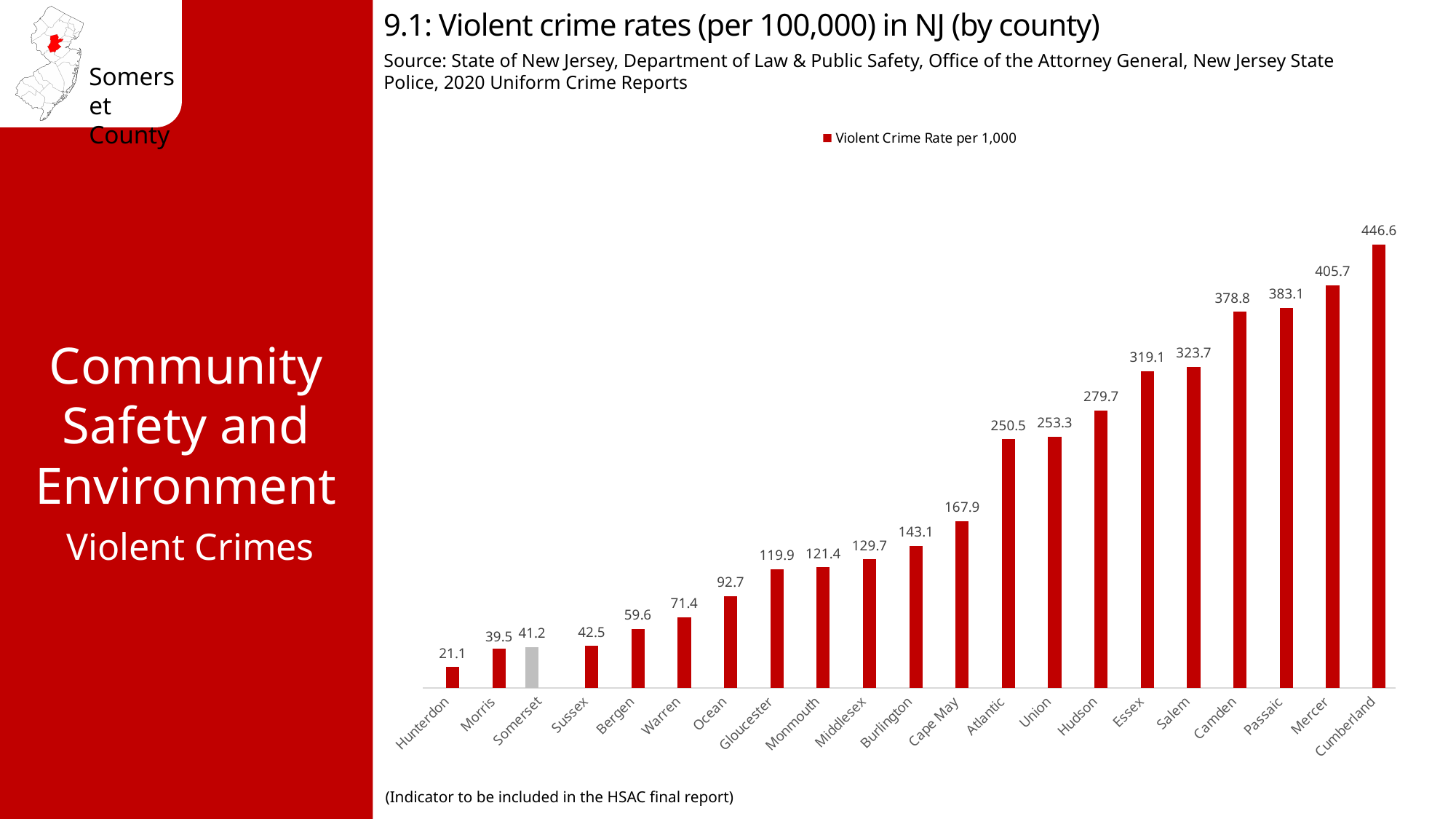
Do the values rise or fall moving from left to right along the x axis? Rise How many counties are shown on the chart? 21 What is the difference between the violent crime rates of Cumberland and Hunterdon? 425.5 Which county has the lowest violent crime rate on the chart? Hunterdon What is the difference between the violent crime rates of Hudson and Union? 26.4 Which county has a higher violent crime rate, Essex or Camden? Camden Which county has the highest violent crime rate on the chart? Cumberland What is the violent crime rate shown for Hudson? 279.7 How many series does the legend list? 1 What kind of chart is shown on the slide? Bar chart What is the violent crime rate shown for Cape May? 167.9 What is the violent crime rate shown for Somerset? 41.2